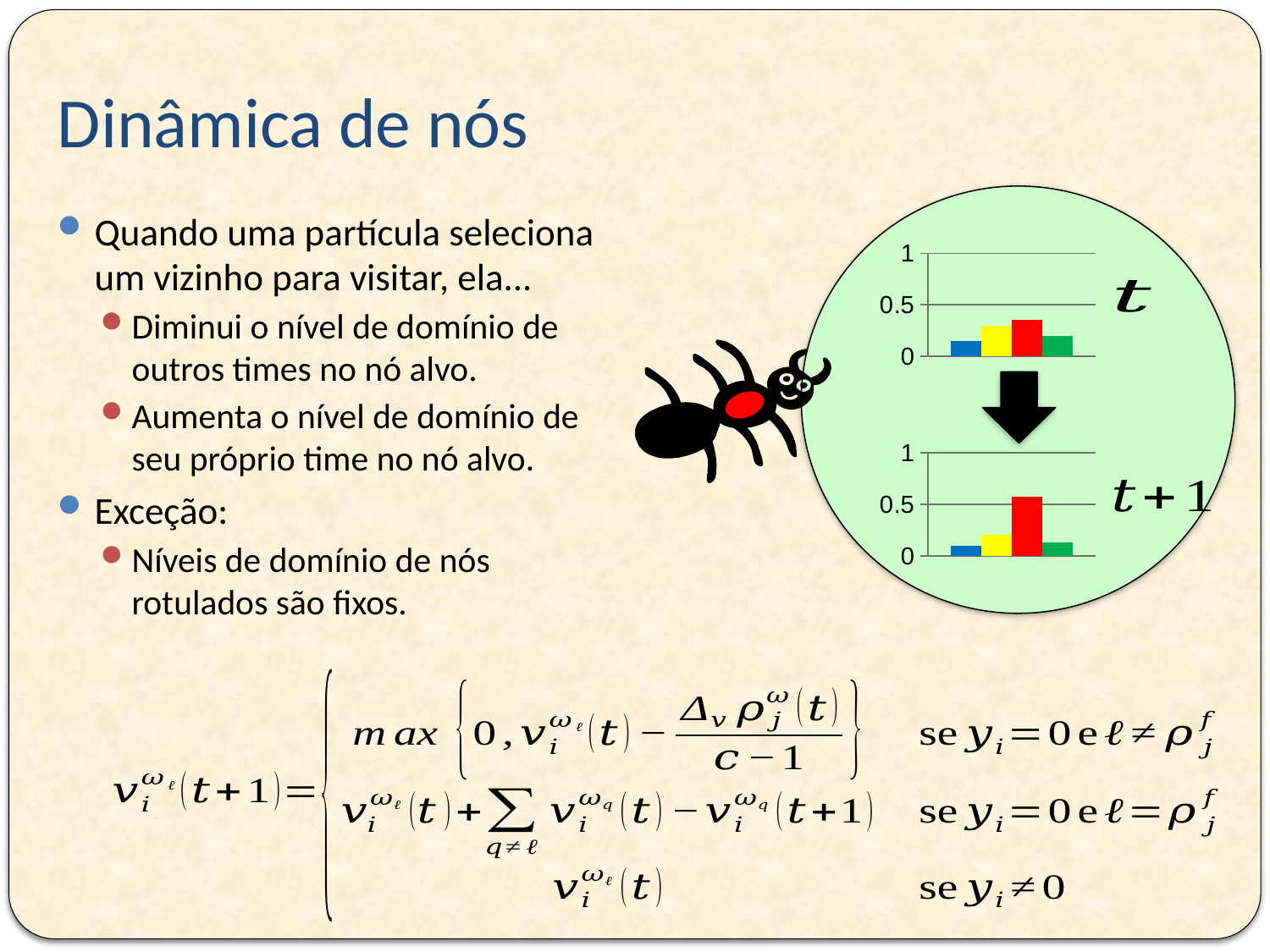
In the chart labelled t, which coloured bar is the tallest? red In the chart labelled t + 1, which is larger, the red bar or the blue bar? red What is the highest tick value shown on the vertical axis of the chart labelled t? 1 In the chart labelled t, is the value of the red bar greater or less than 0.5? less In the chart labelled t + 1, is the value of the red bar greater or less than 0.5? greater In the chart labelled t + 1, is the value of the yellow bar greater or less than 0.5? less What kind of chart is shown in the green circle labelled t? bar chart In the chart labelled t, which coloured bar is the shortest? blue How many bars does the chart labelled t contain? 4 In the chart labelled t + 1, which coloured bar is the tallest? red How many bar charts are shown inside the green circle on the slide? 2 How many bars does the chart labelled t + 1 contain? 4